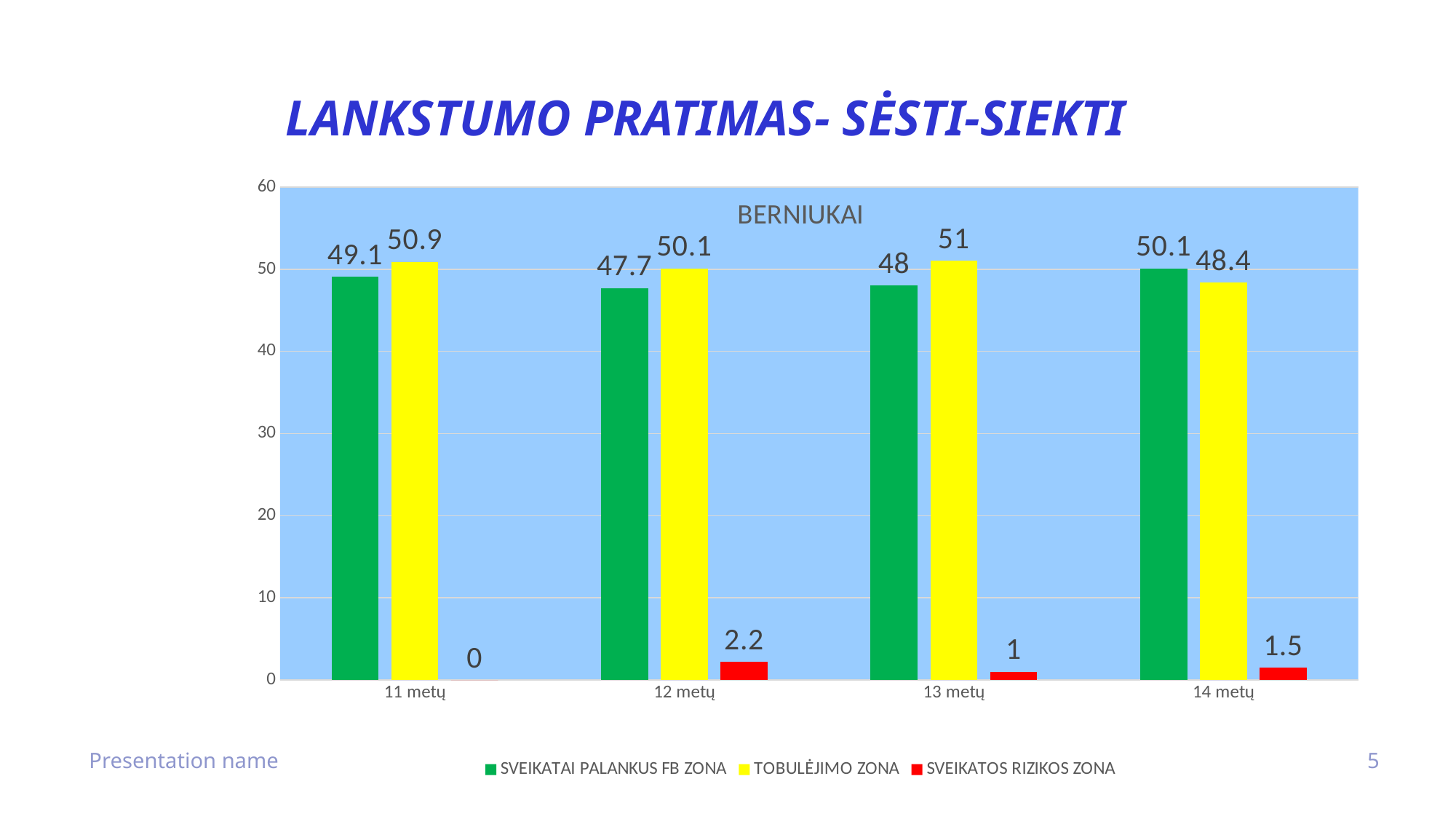
At 14 metų, which is larger: SVEIKATAI PALANKUS FB ZONA or TOBULĖJIMO ZONA? SVEIKATAI PALANKUS FB ZONA How many series does the legend list? 3 What is the difference between the TOBULĖJIMO ZONA and SVEIKATAI PALANKUS FB ZONA values at 12 metų? 2.4 How many age groups are shown on the x axis? 4 What is the value for SVEIKATOS RIZIKOS ZONA at 11 metų? 0 What kind of chart is shown on the slide? Bar chart What is the title shown inside the chart area? BERNIUKAI Which age group has the lowest value for TOBULĖJIMO ZONA? 14 metų Which age group has the highest value for SVEIKATAI PALANKUS FB ZONA? 14 metų What is the value for SVEIKATAI PALANKUS FB ZONA at 11 metų? 49.1 What is the value for SVEIKATOS RIZIKOS ZONA at 12 metų? 2.2 What is the value for TOBULĖJIMO ZONA at 13 metų? 51